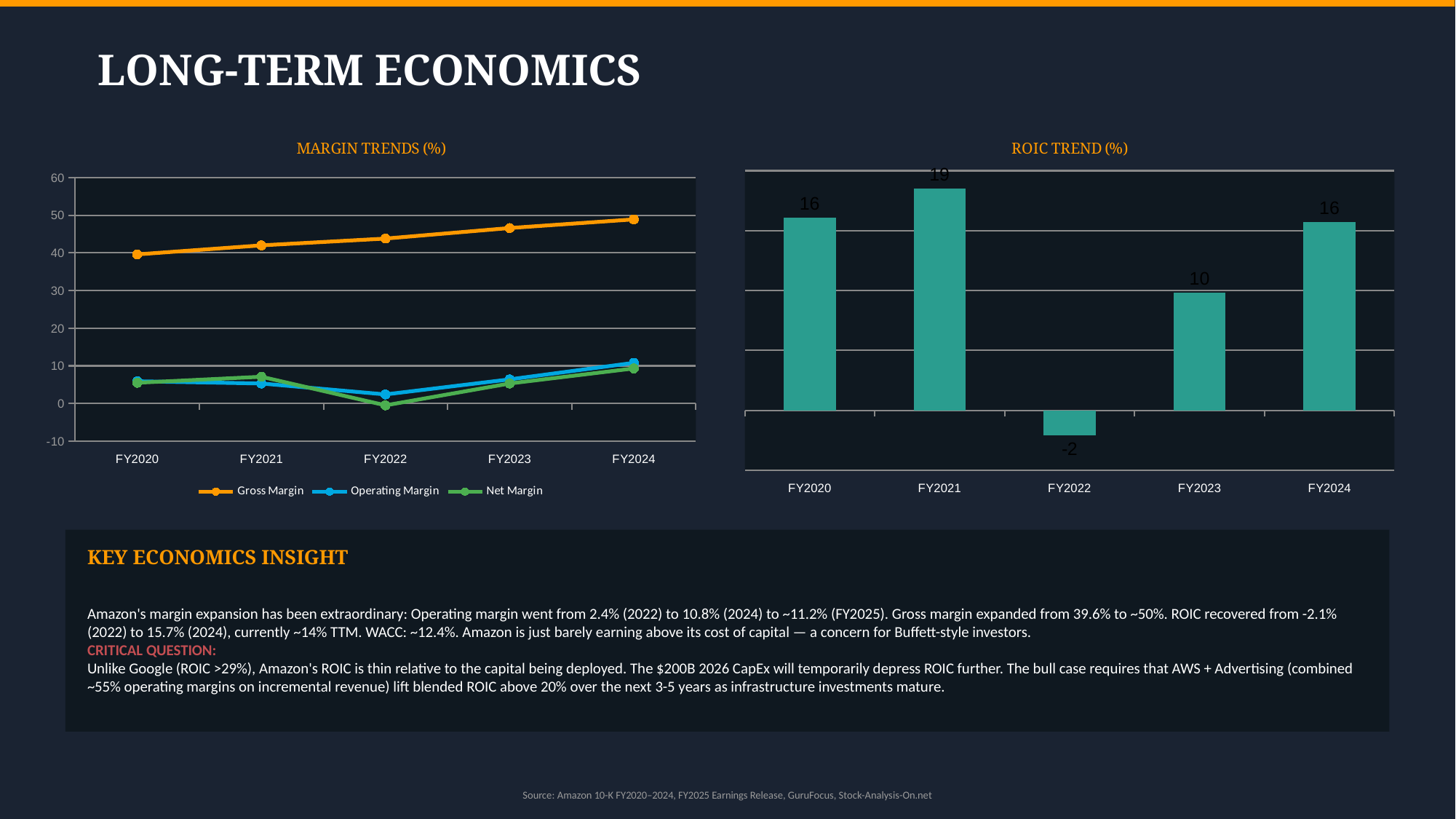
In the MARGIN TRENDS (%) chart, does the Gross Margin rise or fall from FY2020 to FY2024? rise What kind of chart is the ROIC TREND (%) chart? bar chart In the ROIC TREND (%) chart, what is the difference between the FY2021 and FY2023 values? 9 What kind of chart is the MARGIN TRENDS (%) chart? line chart In the ROIC TREND (%) chart, what is the value for FY2021? 19 In the ROIC TREND (%) chart, which fiscal year has the highest ROIC? FY2021 In the ROIC TREND (%) chart, which is larger, the value for FY2023 or FY2024? FY2024 In the MARGIN TRENDS (%) chart, is the Gross Margin value for FY2024 greater or less than 30? greater In the ROIC TREND (%) chart, which fiscal year has the lowest ROIC? FY2022 In the ROIC TREND (%) chart, what is the value for FY2022? -2 How many series does the legend of the MARGIN TRENDS (%) chart list? 3 How many fiscal years are shown in the ROIC TREND (%) chart? 5